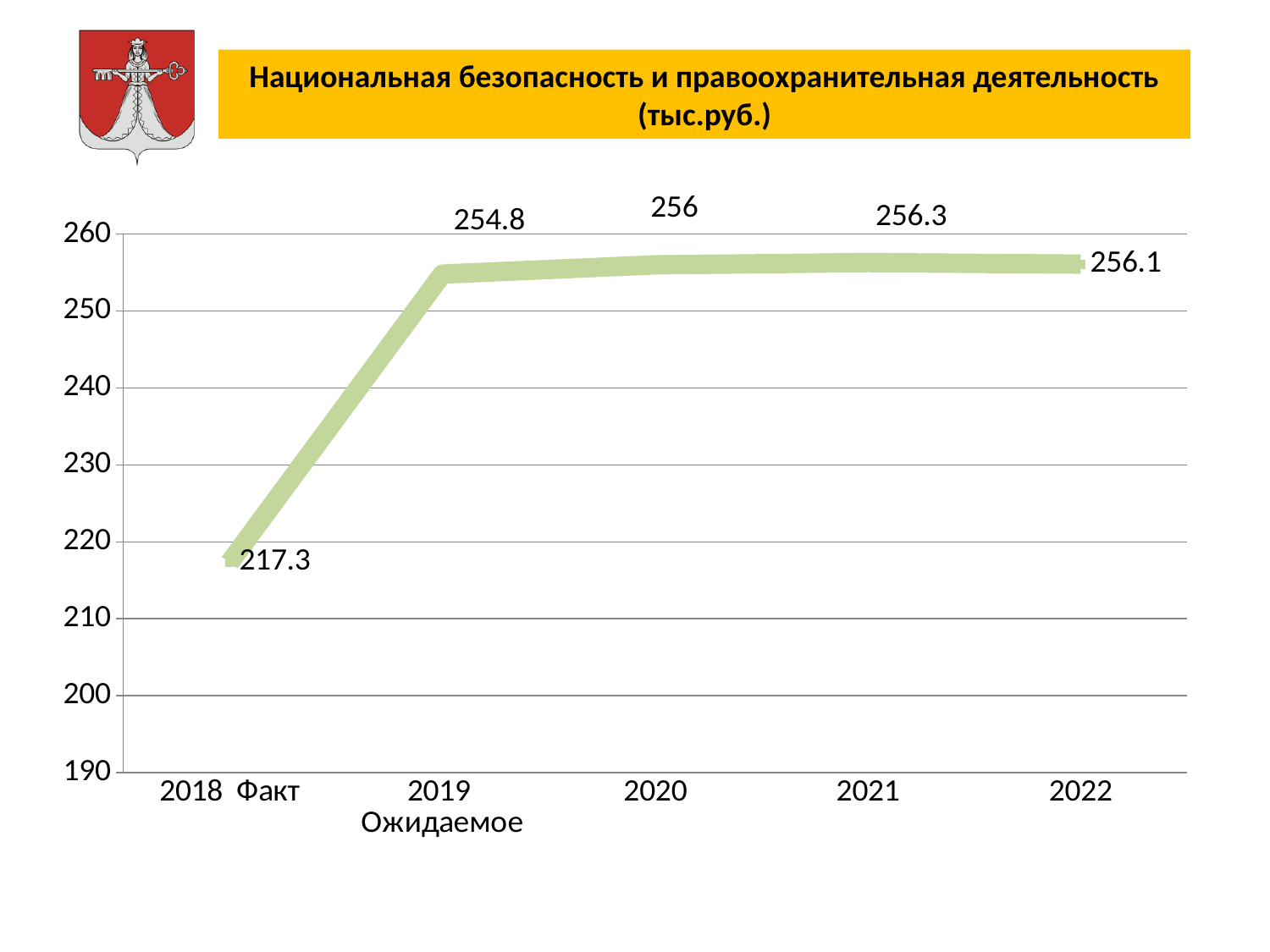
Which year has the highest value? 2021 What kind of chart is shown on the slide? line chart What is the title of the chart? Национальная безопасность и правоохранительная деятельность (тыс.руб.) What is the value for 2022? 256.1 What is the difference between the values for 2019 Ожидаемое and 2018 Факт? 37.5 What is the value for 2021? 256.3 What is the value for 2020? 256 Which year has the lowest value? 2018 Факт Which is larger, the value for 2018 Факт or the value for 2020? 2020 What is the value for 2019 Ожидаемое? 254.8 How many data points are plotted on the chart? 5 What is the value for 2018 Факт? 217.3